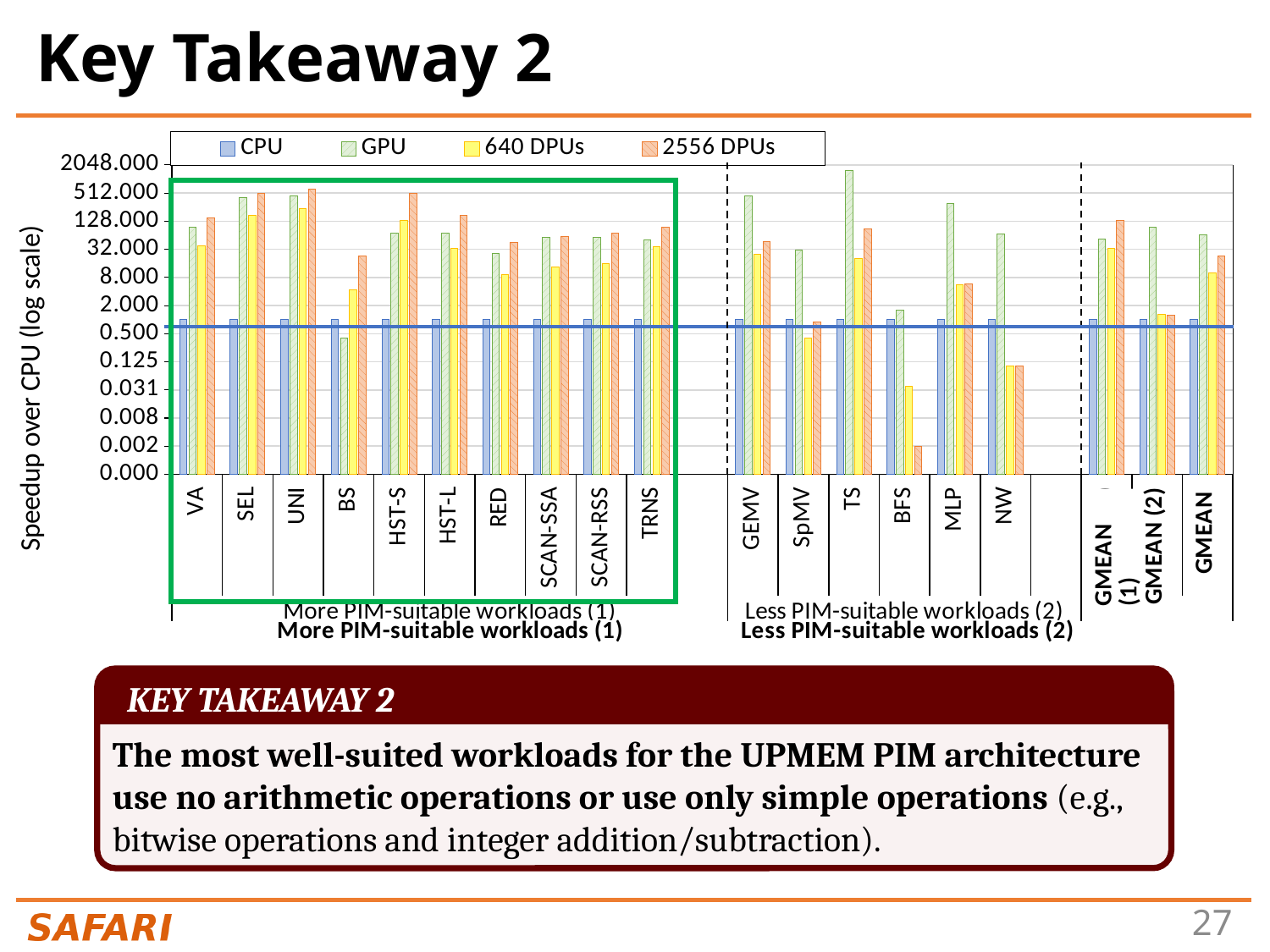
How many series does the chart legend list? 4 Which workload has the tallest GPU bar in the chart? TS Is the 2556 DPUs value for NW greater or less than 0.500? less What kind of chart is shown on the slide? bar chart Is the 2556 DPUs value for BFS greater or less than 0.008? less Is the 640 DPUs value for BFS greater or less than 0.125? less For the MLP workload, which is larger: the GPU value or the 2556 DPUs value? GPU For the BS workload, which is larger: the GPU value or the 2556 DPUs value? 2556 DPUs Which series has the highest bar for the TS workload? GPU What is the label of the y axis of the chart? Speedup over CPU (log scale)